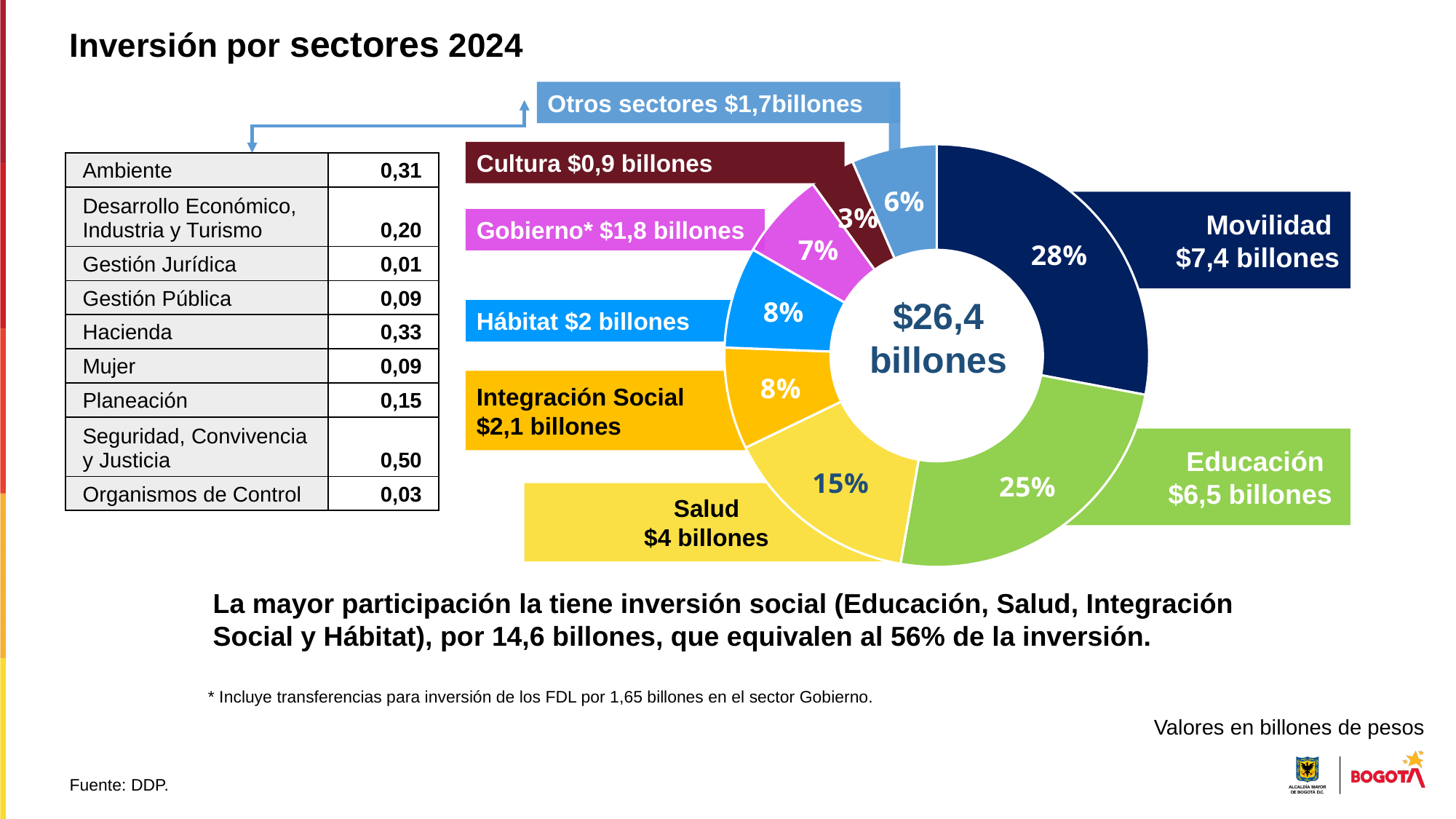
What kind of chart is shown on the slide? Pie (donut) chart What is the difference in investment between Movilidad and Educación? $0,8 billones What percentage share of the chart does Educación have? 25% How many sectors (slices) are shown in the chart? 8 What is the title of the chart? Inversión por sectores 2024 Which sector has the largest share of the investment? Movilidad Which sector has the smallest share of the investment? Cultura Which has a larger investment, Hábitat or Gobierno*? Hábitat What is the total investment shown in the centre of the chart? $26,4 billones What percentage share does Otros sectores have? 6% What is the investment value for Movilidad? $7,4 billones What is the investment value for Salud? $4 billones